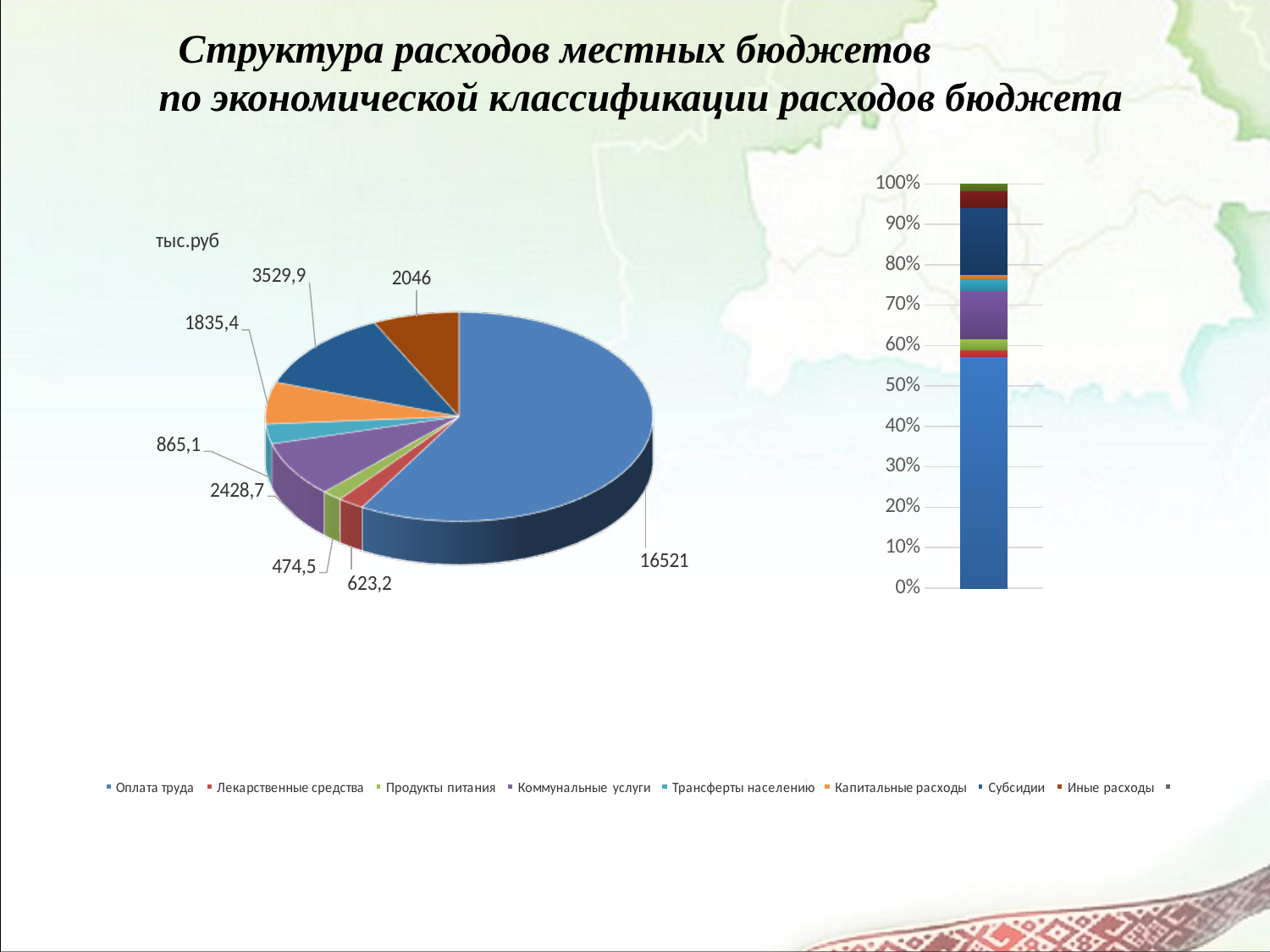
In the pie chart, which is larger: Лекарственные средства or Трансферты населению? Трансферты населению In the stacked bar chart on the right, is the share for Оплата труда greater or less than 50%? greater In the pie chart, what is the value for Коммунальные услуги? 2428,7 What kind of chart is shown on the left of the slide? pie chart How many slices does the pie chart have? 8 In the pie chart, what is the value for Оплата труда? 16521 What unit is indicated above the pie chart? тыс.руб In the pie chart, what is the difference between the values for Субсидии and Иные расходы? 1483,9 In the pie chart, what is the value for Субсидии? 3529,9 In the pie chart, which category has the smallest value? Продукты питания In the pie chart, what is the value for Капитальные расходы? 1835,4 In the pie chart, which category has the largest value? Оплата труда